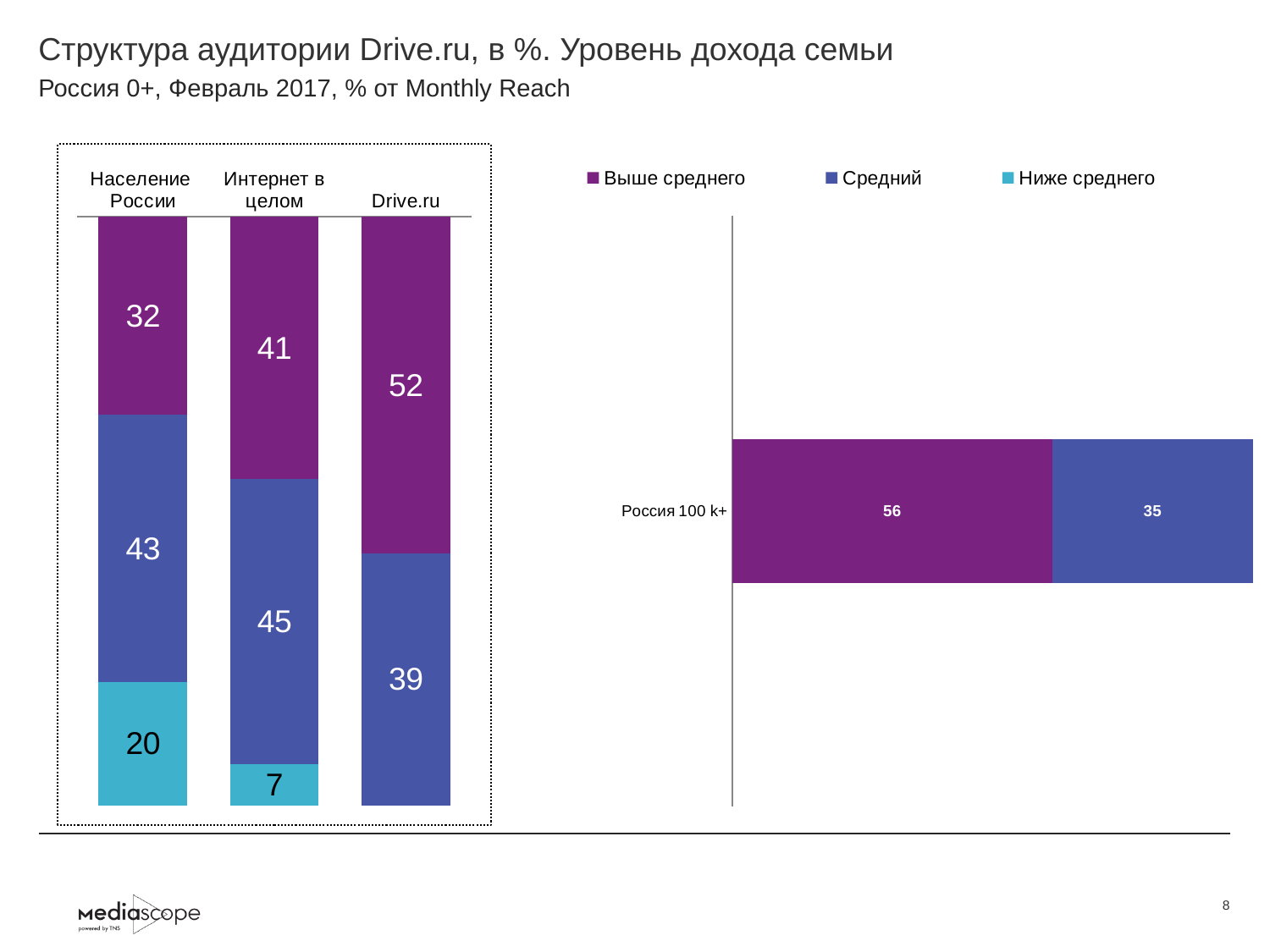
How many categories are shown in the left chart? 3 In the left chart, which category has the lowest Ниже среднего value among those with a labelled Ниже среднего segment? Интернет в целом In the left chart, what is the value of the Средний segment for Население России? 43 In the left chart, what is the value of the Ниже среднего segment for Интернет в целом? 7 In the left chart, what is the difference between the Выше среднего values for Drive.ru and Население России? 20 In the right chart, what is the difference between the Выше среднего and Средний values for Россия 100 k+? 21 How many series does the legend list? 3 In the left chart, which is larger: the Средний value for Интернет в целом or for Drive.ru? Интернет в целом In the right chart, what is the Выше среднего value for Россия 100 k+? 56 In the left chart, what is the value of the Выше среднего segment for Drive.ru? 52 In the left chart, what is the total of the labelled segments for Население России? 95 In the left chart, which category has the highest Выше среднего value? Drive.ru